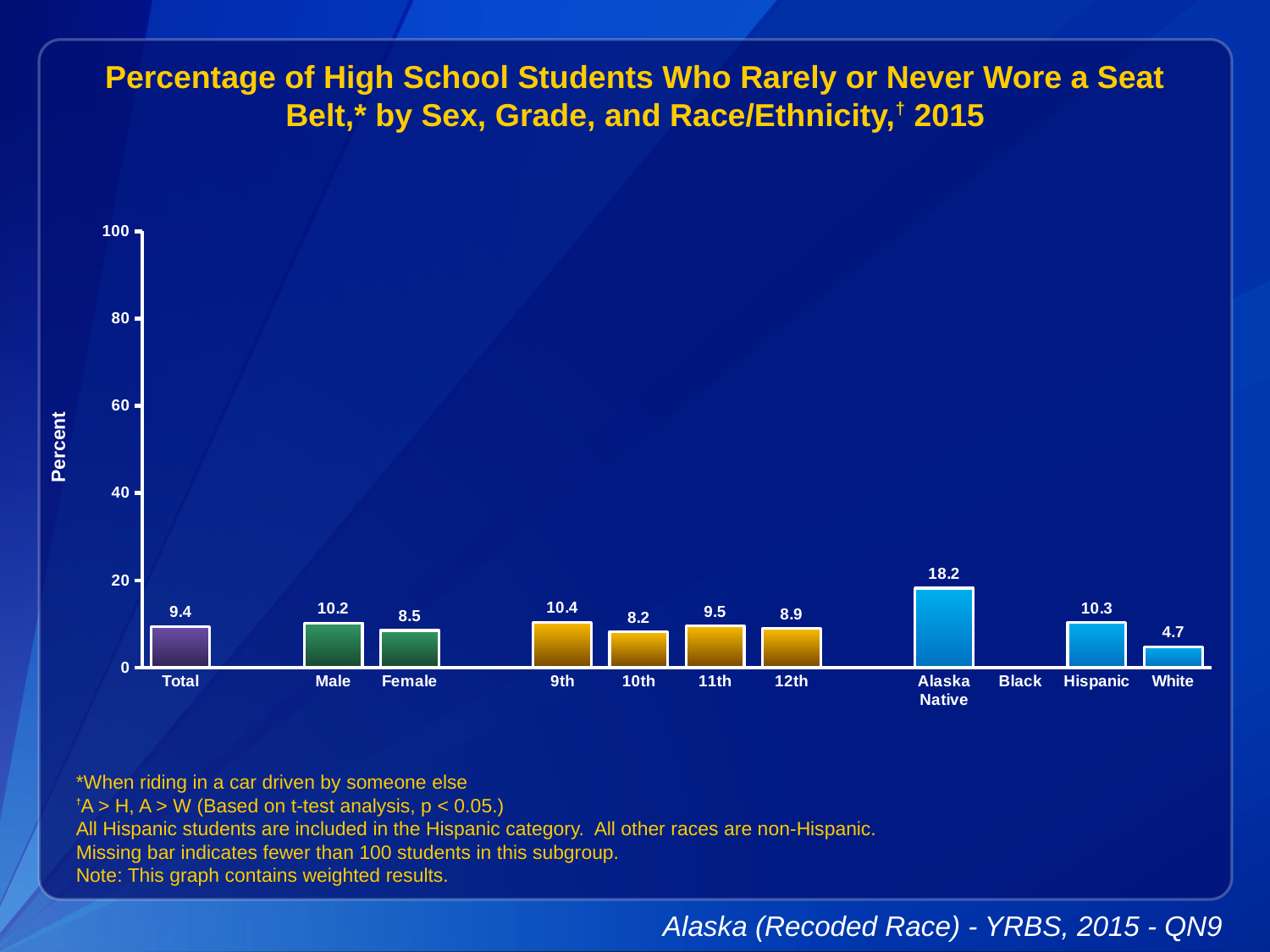
What is the difference between the Male and Female values? 1.7 Is the value for Alaska Native greater or less than 20? less Which category has the highest value? Alaska Native Which is larger, the value for 9th or the value for 10th? 9th What is the value for Male? 10.2 Which category with a bar has the lowest value? White What is the value for White? 4.7 Which category has no bar shown? Black What is the value for Total? 9.4 How many categories have a bar plotted? 11 What kind of chart is shown? bar chart What is the value for Alaska Native? 18.2